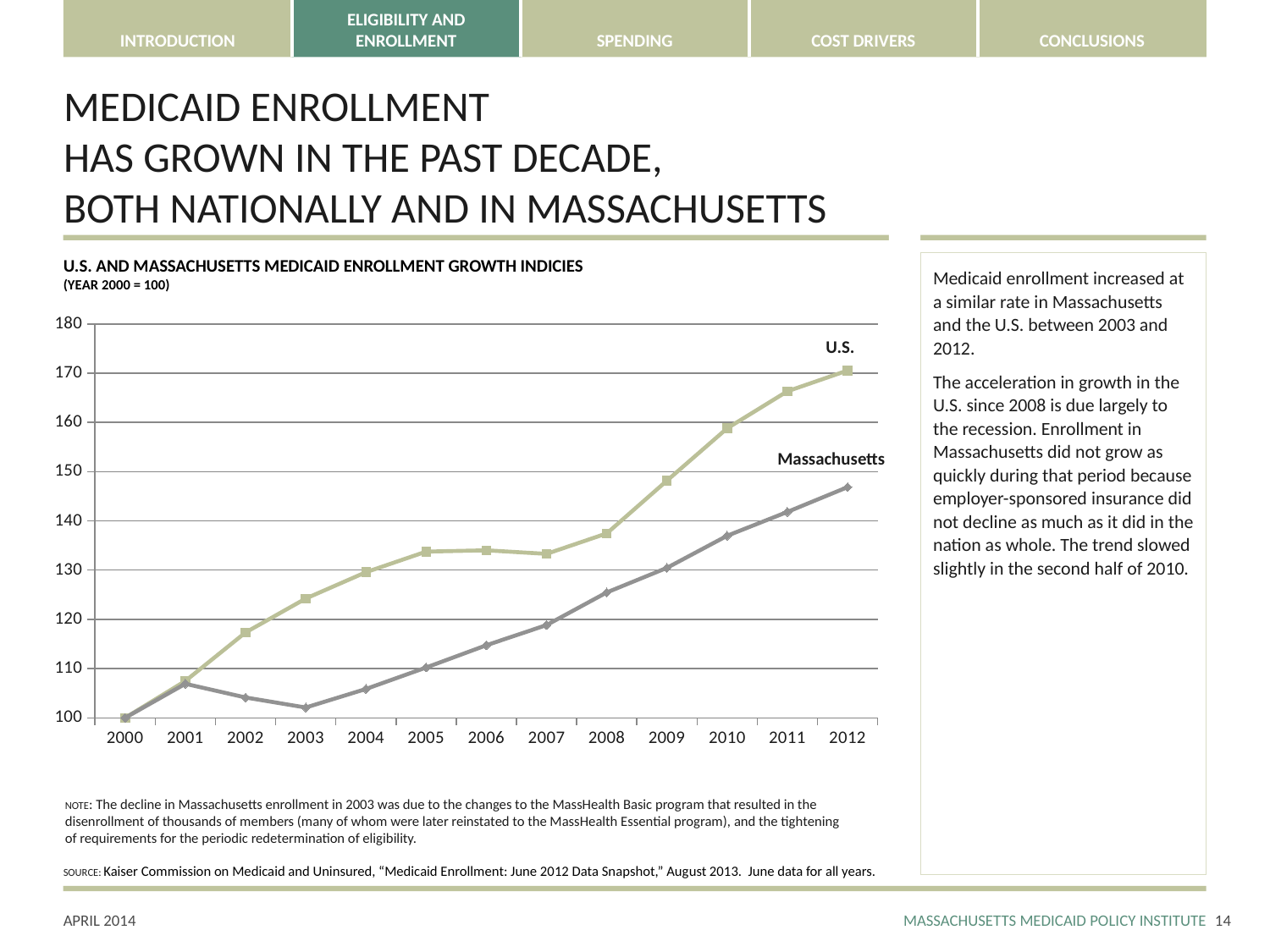
How many years are shown along the x axis of the chart? 13 Between 2001 and 2005, in which year is the Massachusetts value lowest? 2003 What kind of chart is shown on the slide? line chart In 2012, which series has the higher index value, U.S. or Massachusetts? U.S. Is the U.S. value in 2012 greater or less than 160? greater Is the Massachusetts value in 2012 greater or less than 140? greater What is the index value for the U.S. in 2000? 100 Is the U.S. value in 2010 greater or less than 150? greater What base year is the index set to 100, according to the chart subtitle? 2000 How many series are plotted on the chart? 2 In which year does the U.S. series reach its highest value? 2012